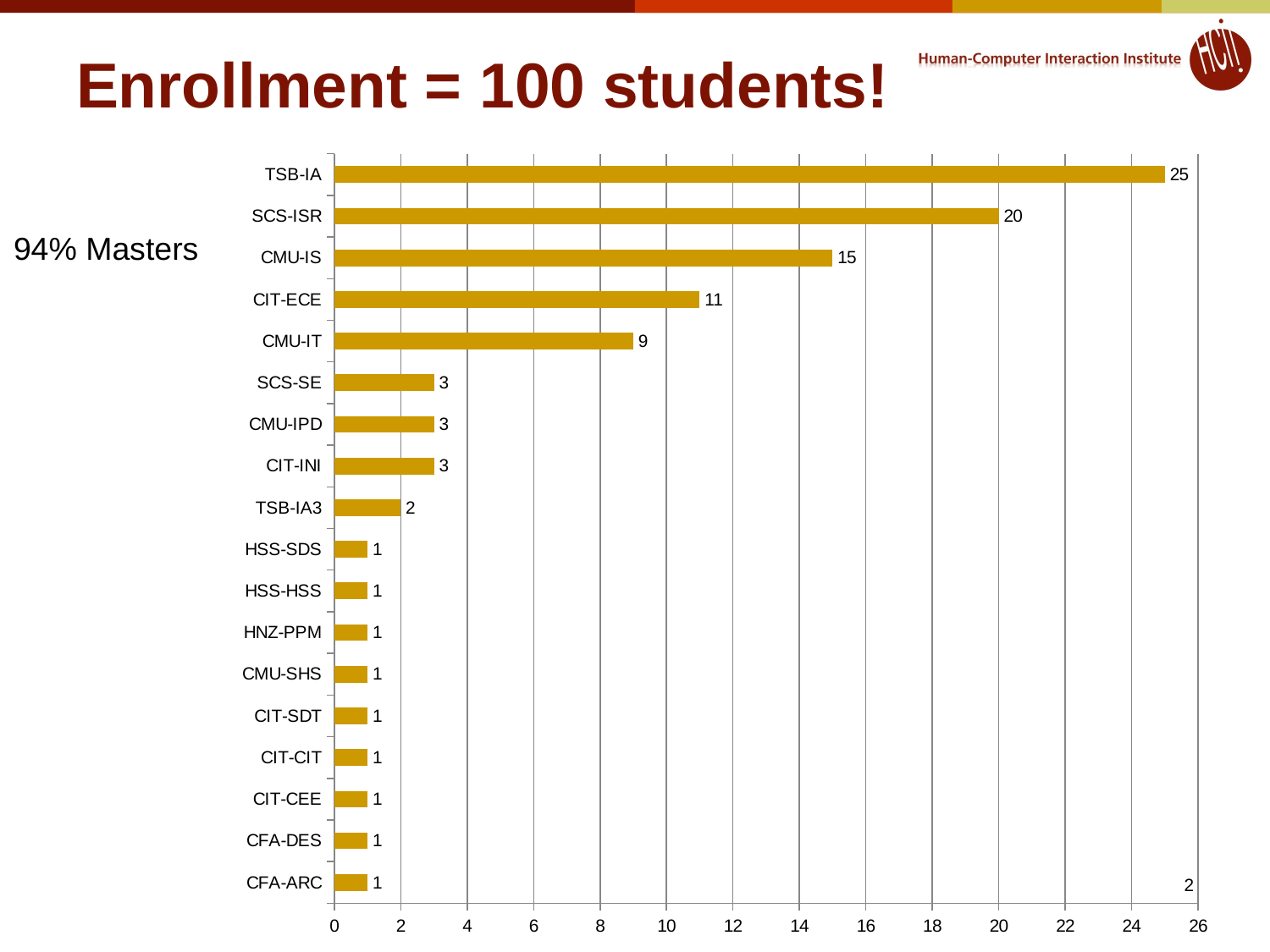
Which category has the highest value? TSB-IA Which is larger, the value for CIT-ECE or the value for CMU-IS? CMU-IS What is the value for TSB-IA? 25 What is the value for CMU-IT? 9 What is the difference between the values for SCS-ISR and CMU-IS? 5 What is the value for TSB-IA3? 2 Is the value for SCS-ISR greater or less than 18? greater How many categories are shown in the chart? 18 What is the title of the slide containing the chart? Enrollment = 100 students! What is the value for CIT-ECE? 11 What is the difference between the values for TSB-IA and CMU-IT? 16 What kind of chart is shown on the slide? Bar chart